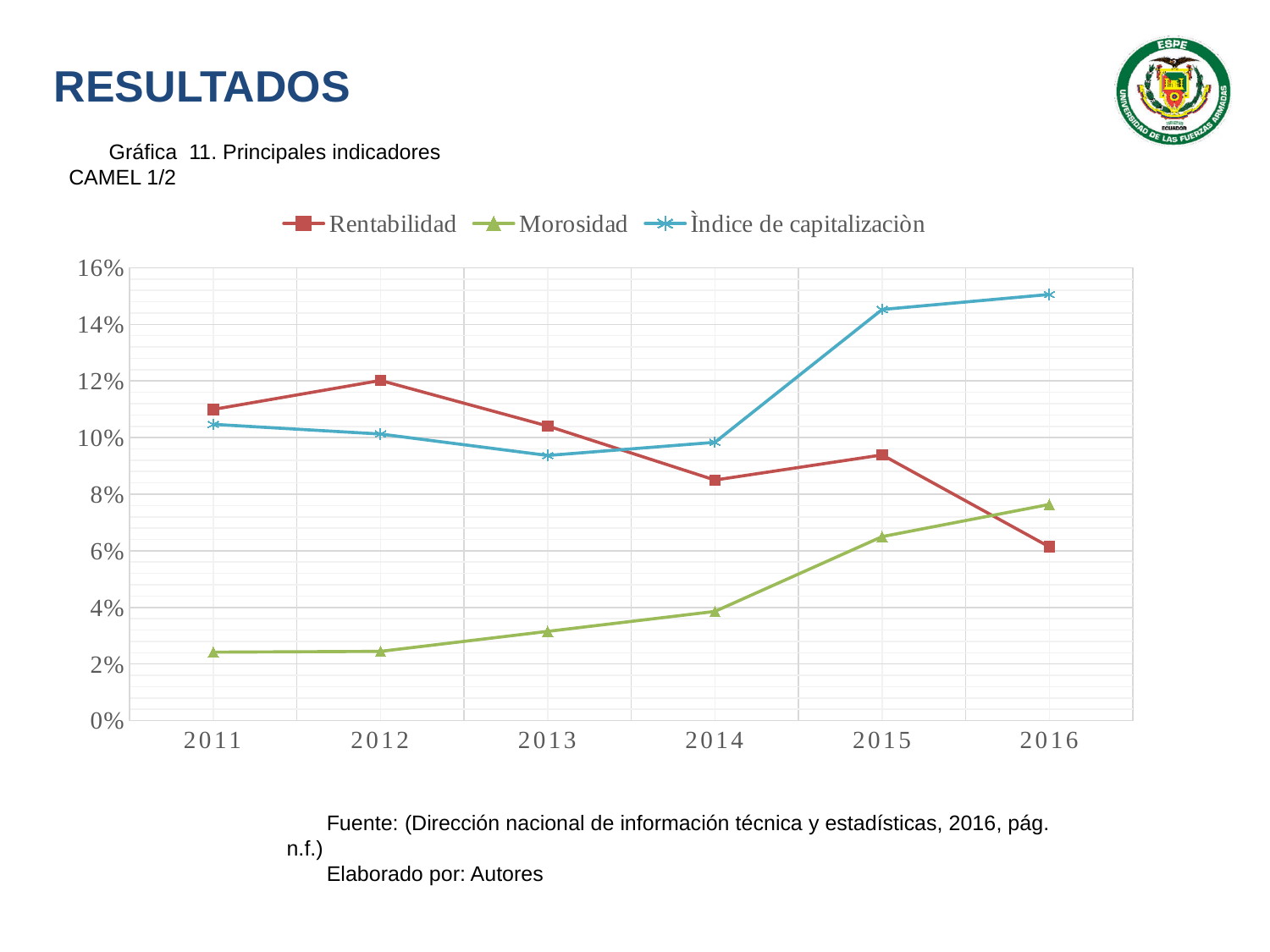
In which year is Rentabilidad lowest? 2016 How many years are shown on the x axis? 6 Is the value for Morosidad in 2011 greater or less than 4%? less In which year is Morosidad highest? 2016 Is the value for Índice de capitalización in 2015 greater or less than 12%? greater Does Morosidad rise or fall from 2011 to 2016? rise In which year is Índice de capitalización highest? 2016 What kind of chart is shown on the slide? line chart Which marker shape is used for the Morosidad series in the legend? triangle In 2016, which is larger: Rentabilidad or Morosidad? Morosidad How many series does the legend list? 3 In 2013, which is larger: Rentabilidad or Índice de capitalización? Rentabilidad